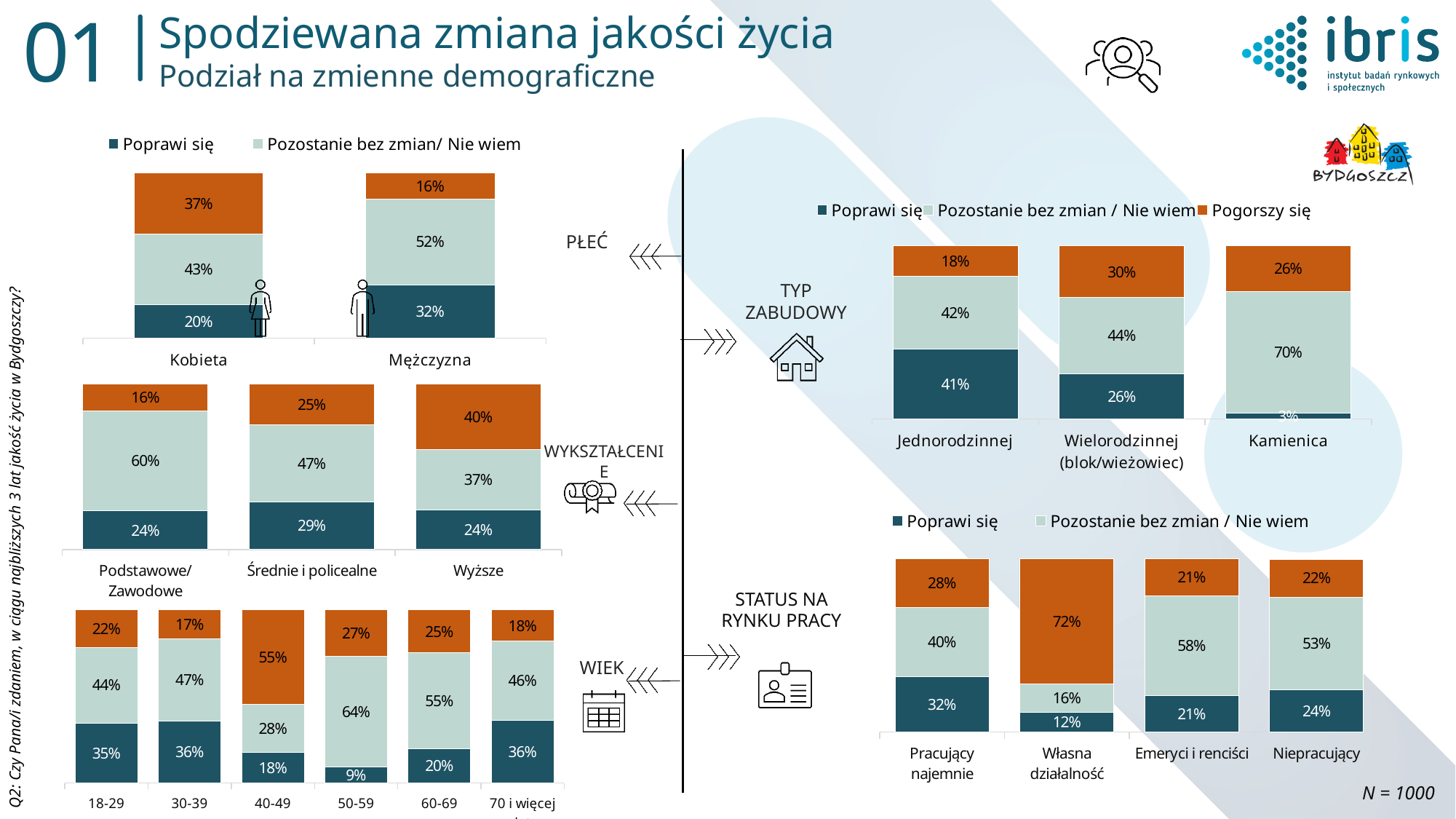
In the STATUS NA RYNKU PRACY chart, which category has the highest 'Pogorszy się' value? Własna działalność In the PŁEĆ chart, what is the 'Pogorszy się' value for Mężczyzna? 16% In the WIEK chart, what is the 'Pogorszy się' value for the 40-49 age group? 55% In the WIEK chart, which age group has the lowest 'Poprawi się' value? 50-59 In the TYP ZABUDOWY chart, which building type has the highest 'Pozostanie bez zmian / Nie wiem' share? Kamienica How many series does the legend of the TYP ZABUDOWY chart list? 3 In the WYKSZTAŁCENIE chart, which education category has the highest 'Pogorszy się' share? Wyższe In the WIEK chart, how many age categories are shown? 6 In the STATUS NA RYNKU PRACY chart, is the 'Poprawi się' value larger for Pracujący najemnie or for Niepracujący? Pracujący najemnie In the PŁEĆ chart, what percentage of Kobieta answered 'Poprawi się'? 20% In the TYP ZABUDOWY chart, what is the 'Poprawi się' value for Jednorodzinnej? 41% In the WYKSZTAŁCENIE chart, what is the difference between the 'Pozostanie bez zmian/Nie wiem' values for Podstawowe/Zawodowe and Wyższe? 23 percentage points